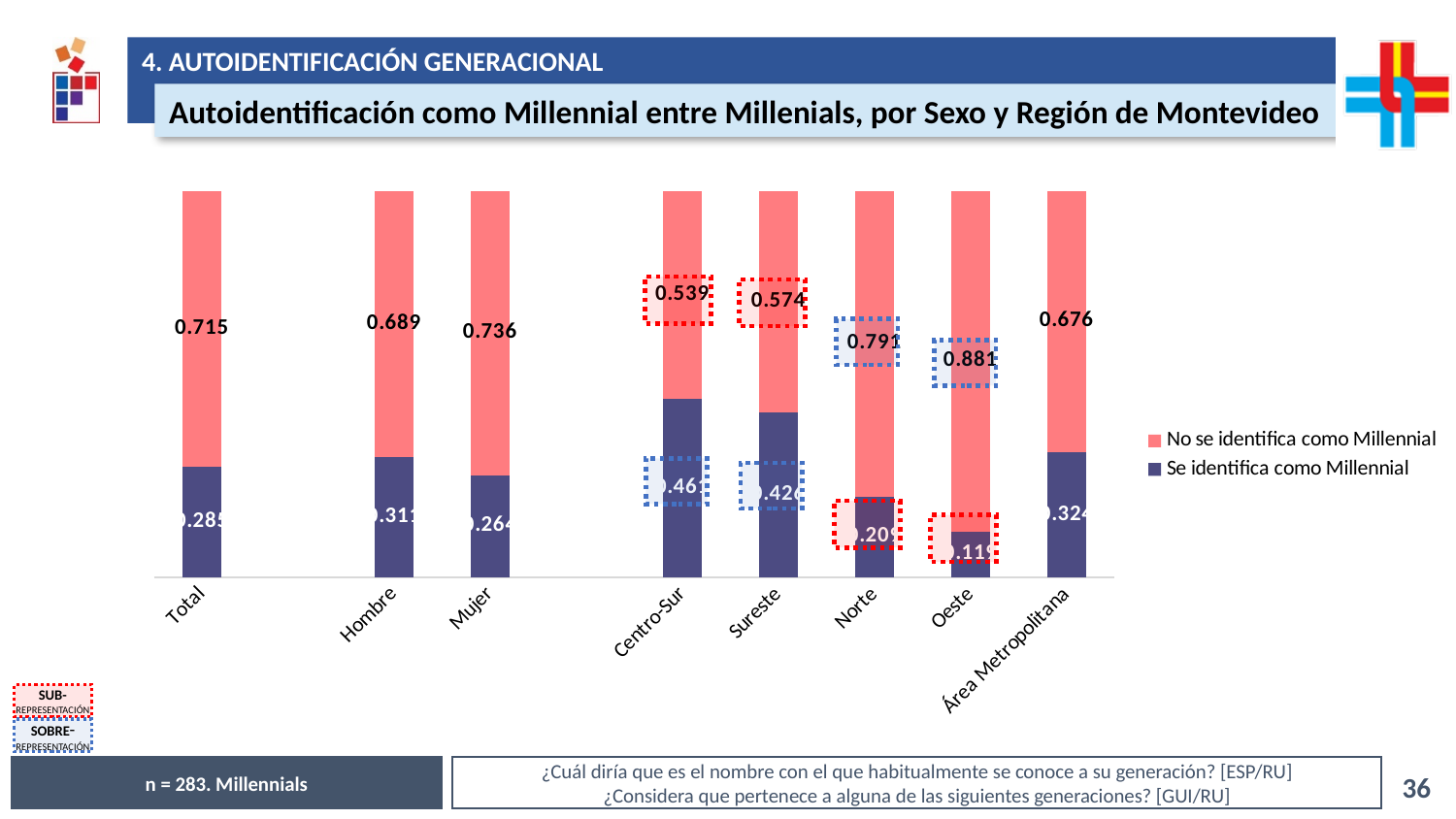
What is the value of 'No se identifica como Millennial' for Centro-Sur? 0.539 How many categories are shown on the x axis? 8 How many series does the legend list? 2 What type of chart is shown on the slide? Stacked bar chart Which category has the highest value for 'No se identifica como Millennial'? Oeste Which series is shown in dark blue in the legend? Se identifica como Millennial Which category has the lowest value for 'No se identifica como Millennial'? Centro-Sur What is the value of 'No se identifica como Millennial' for Total? 0.715 What is the value of 'No se identifica como Millennial' for Área Metropolitana? 0.676 What is the difference between the 'No se identifica como Millennial' values for Mujer and Hombre? 0.047 Which has a larger 'No se identifica como Millennial' value, Norte or Sureste? Norte What is the value of 'No se identifica como Millennial' for Oeste? 0.881